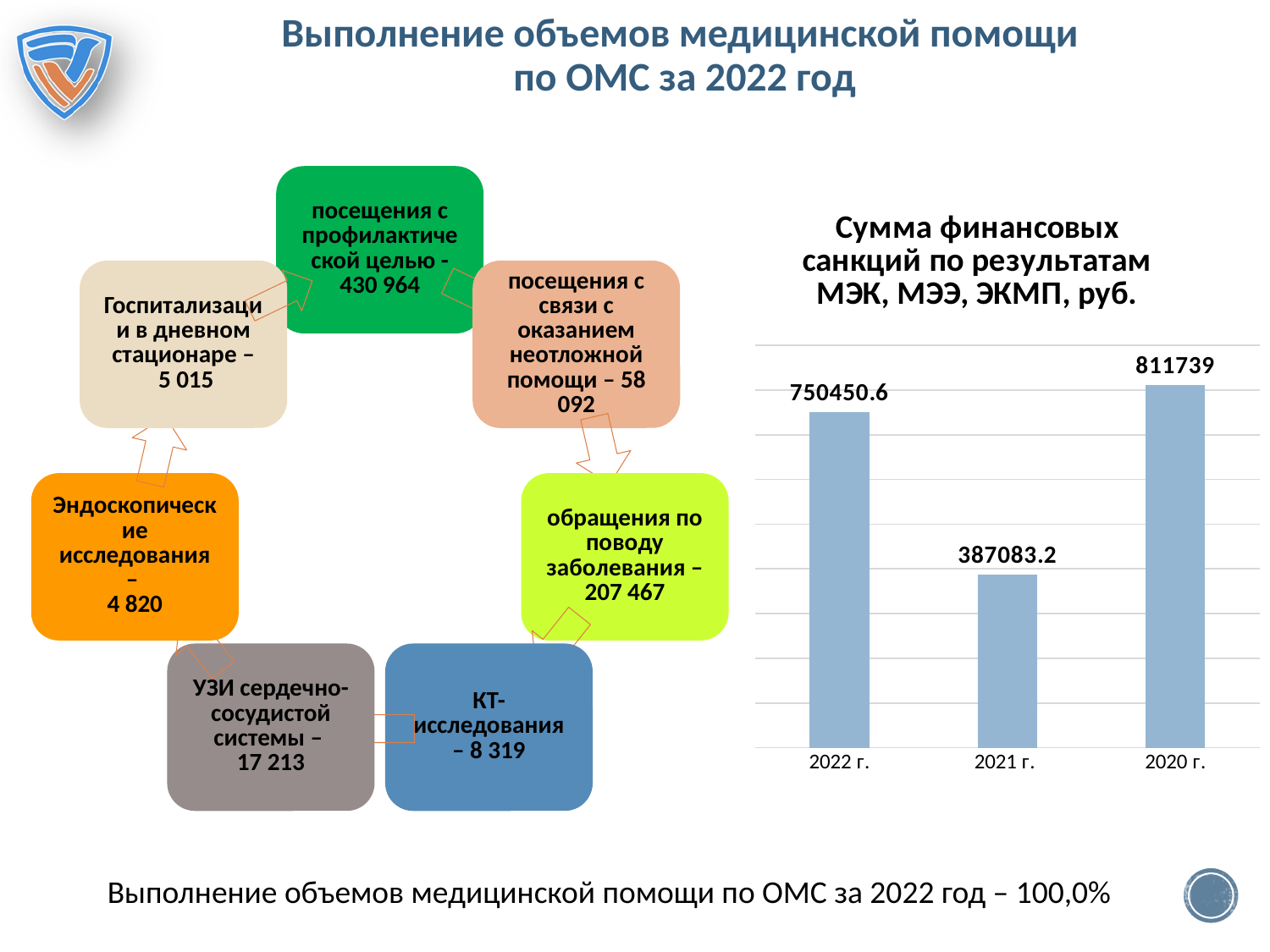
What is the value for 2021 г. in the bar chart? 387083.2 Which year has the lowest value in the bar chart? 2021 г. How many categories are shown in the bar chart? 3 What is the title of the bar chart on the slide? Сумма финансовых санкций по результатам МЭК, МЭЭ, ЭКМП, руб. What is the value for 2020 г. in the bar chart? 811739 Does the value rise or fall from 2022 г. to 2021 г. in the bar chart? fall What is the difference between the values for 2020 г. and 2022 г. in the bar chart? 61288.4 What kind of chart is used to show the sum of financial sanctions? bar chart Which year has the highest value in the bar chart? 2020 г. What is the value for 2022 г. in the chart 'Сумма финансовых санкций по результатам МЭК, МЭЭ, ЭКМП, руб.'? 750450.6 Which is larger in the bar chart, the value for 2022 г. or the value for 2021 г.? 2022 г. What is the difference between the values for 2022 г. and 2021 г. in the bar chart? 363367.4